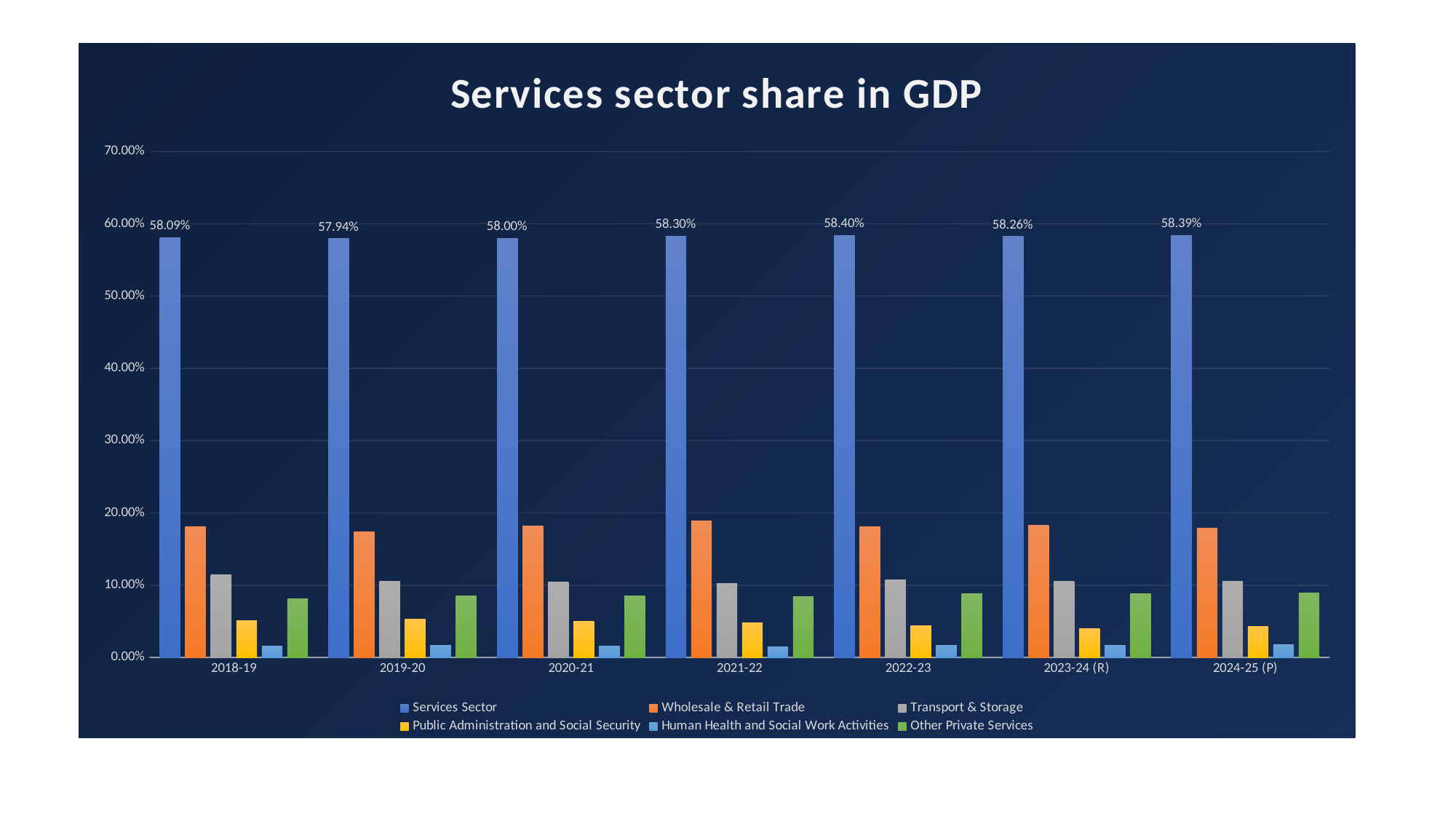
In which year is the Services Sector share in GDP lowest? 2019-20 What kind of chart is shown on the slide? Bar chart How many series does the legend list? 6 Is the value for Wholesale & Retail Trade in 2021-22 greater or less than 20.00%? less What is the difference between the Services Sector share in 2022-23 and in 2019-20? 0.46% What is the Services Sector share in GDP for 2019-20? 57.94% What is the Services Sector share in GDP for 2024-25 (P)? 58.39% Is the value for Transport & Storage in 2018-19 greater or less than 10.00%? greater How many years are shown on the x axis? 7 In which year is the Services Sector share in GDP highest? 2022-23 What is the Services Sector share in GDP for 2022-23? 58.40% Is the Services Sector share in 2021-22 larger than in 2018-19? Yes, 58.30% vs 58.09%